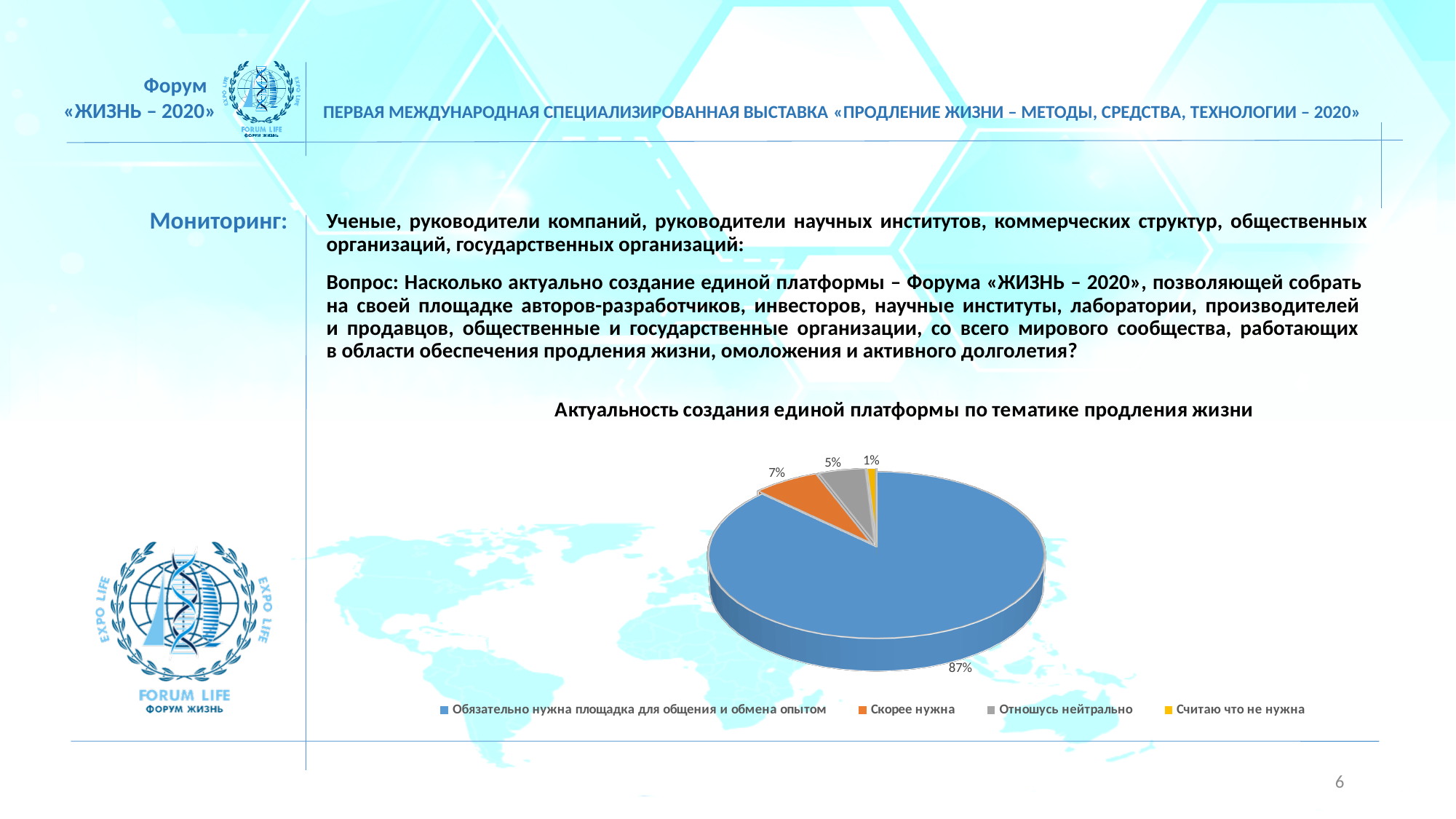
What share of the pie is labelled "Считаю что не нужна"? 1% Which category has the smallest slice of the pie? Считаю что не нужна What colour is the slice for "Отношусь нейтрально"? Grey What is the difference in percentage points between "Скорее нужна" and "Отношусь нейтрально"? 2% How many slices does the pie chart have? 4 What kind of chart is shown on the slide? Pie chart Which is larger: the share for "Скорее нужна" or the share for "Считаю что не нужна"? Скорее нужна What share of the pie is labelled "Отношусь нейтрально"? 5% What share of the pie is labelled "Скорее нужна"? 7% Which category has the largest slice of the pie? Обязательно нужна площадка для общения и обмена опытом What is the chart's title? Актуальность создания единой платформы по тематике продления жизни